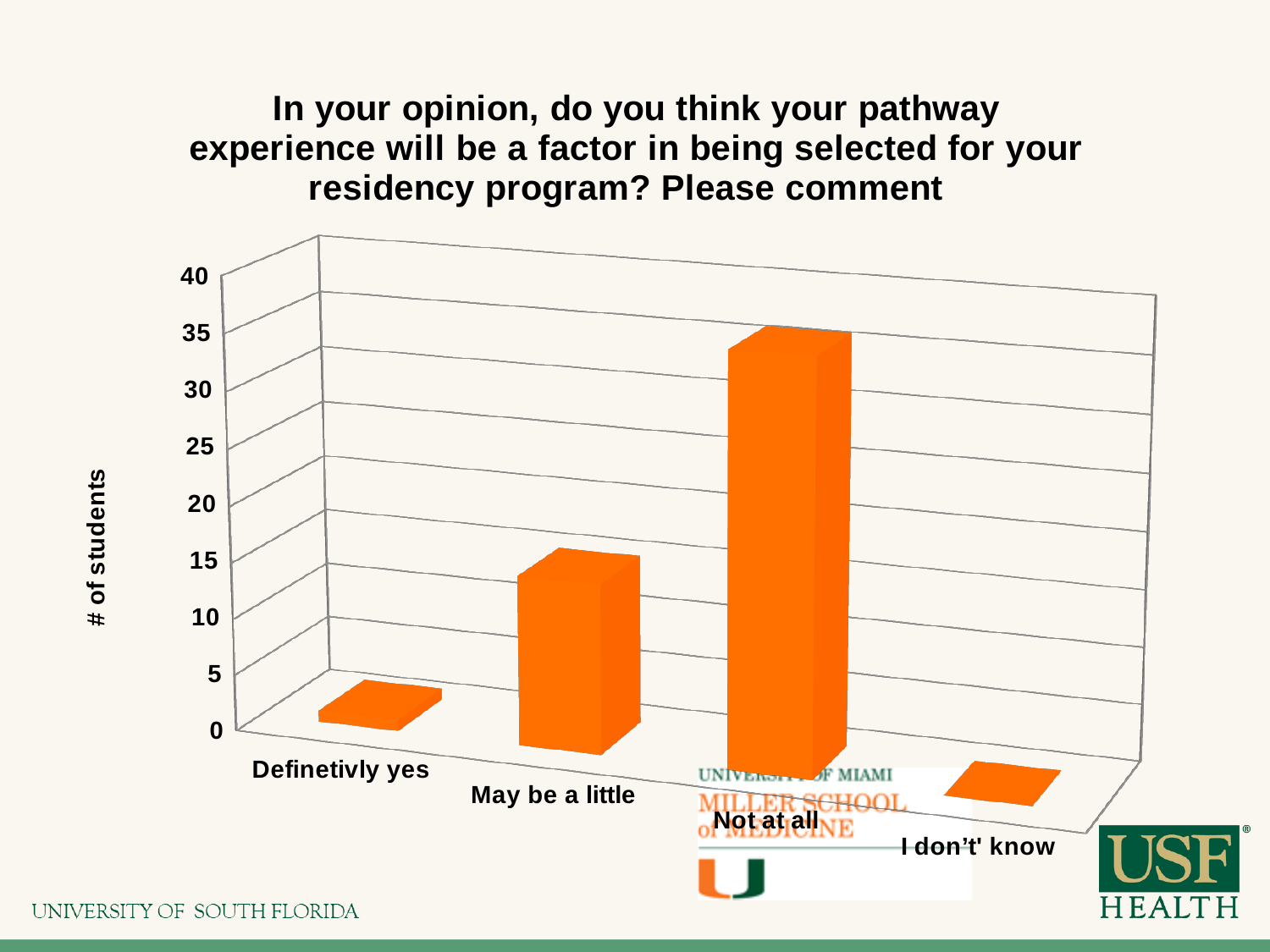
What is the label on the vertical axis of the chart? # of students Is the value for "Not at all" greater or less than 30? greater Which has more students, "Not at all" or "May be a little"? Not at all Which category has the highest number of students? Not at all Is the value for "May be a little" greater or less than 10? greater Is the value for "May be a little" greater or less than 20? less How many categories are shown on the x axis of the chart? 4 What kind of chart is shown on the slide? bar chart What is the highest value shown on the vertical axis of the chart? 40 Which has more students, "May be a little" or "Definetivly yes"? May be a little